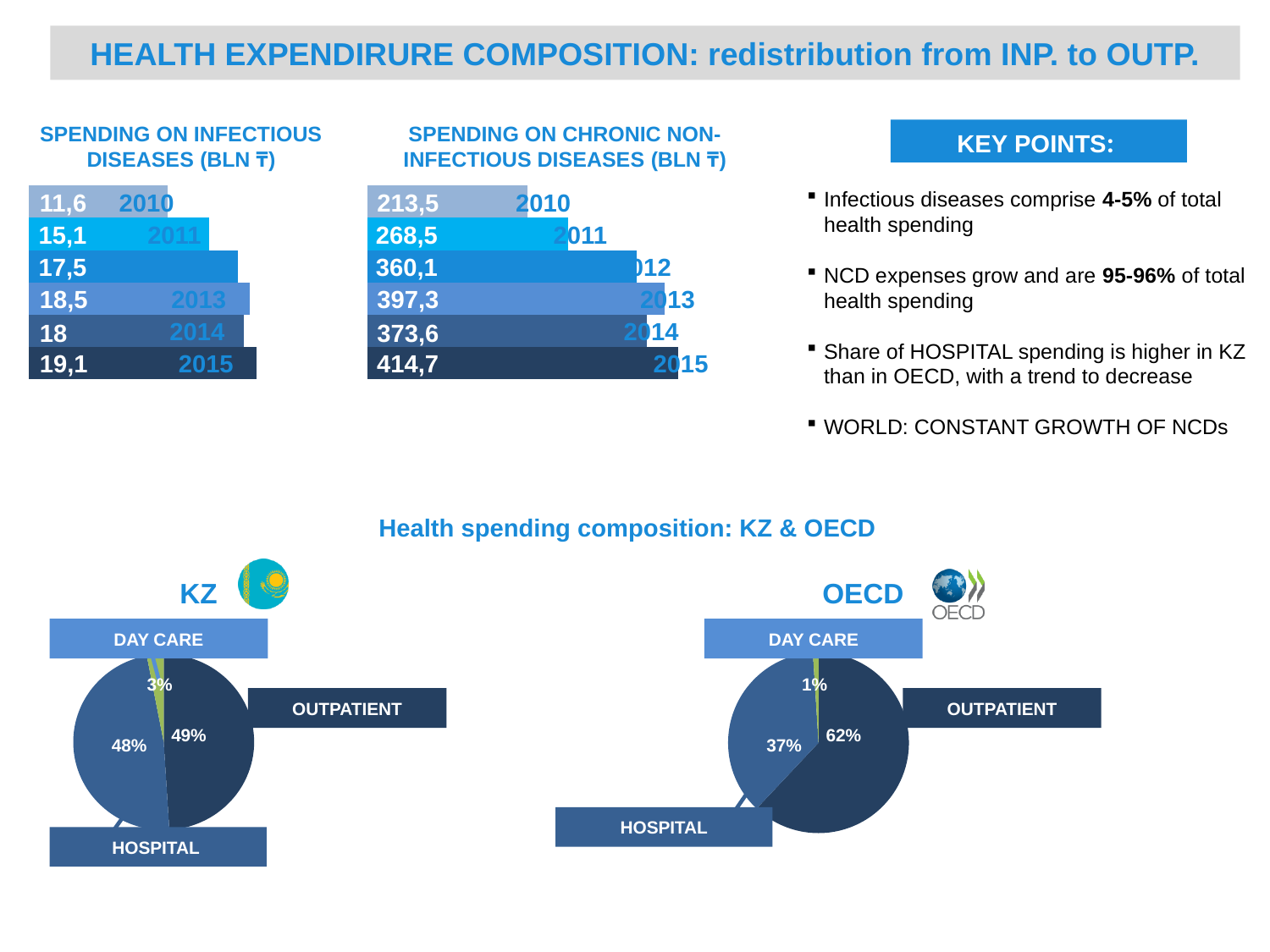
In the 'Spending on chronic non-infectious diseases' chart, what is the difference between the 2015 and 2010 values? 201,2 In the 'Spending on infectious diseases' chart, what is the value for 2015? 19,1 In the 'Spending on chronic non-infectious diseases' chart, which year has the highest value? 2015 Which pie chart shows the larger Day Care share, KZ or OECD? KZ In the OECD pie chart, what share is Outpatient? 62% In the OECD pie chart, what is the difference between the Outpatient and Hospital shares? 25% In the 'Spending on infectious diseases' chart, which year has the lowest value? 2010 In the 'Spending on infectious diseases' chart, which year has the larger value, 2013 or 2014? 2013 In the KZ pie chart, what share is Hospital? 48% In the 'Spending on chronic non-infectious diseases' chart, what is the value for 2013? 397,3 What kind of chart is the 'Spending on chronic non-infectious diseases' chart? Bar chart How many bars are shown in the 'Spending on infectious diseases' chart? 6